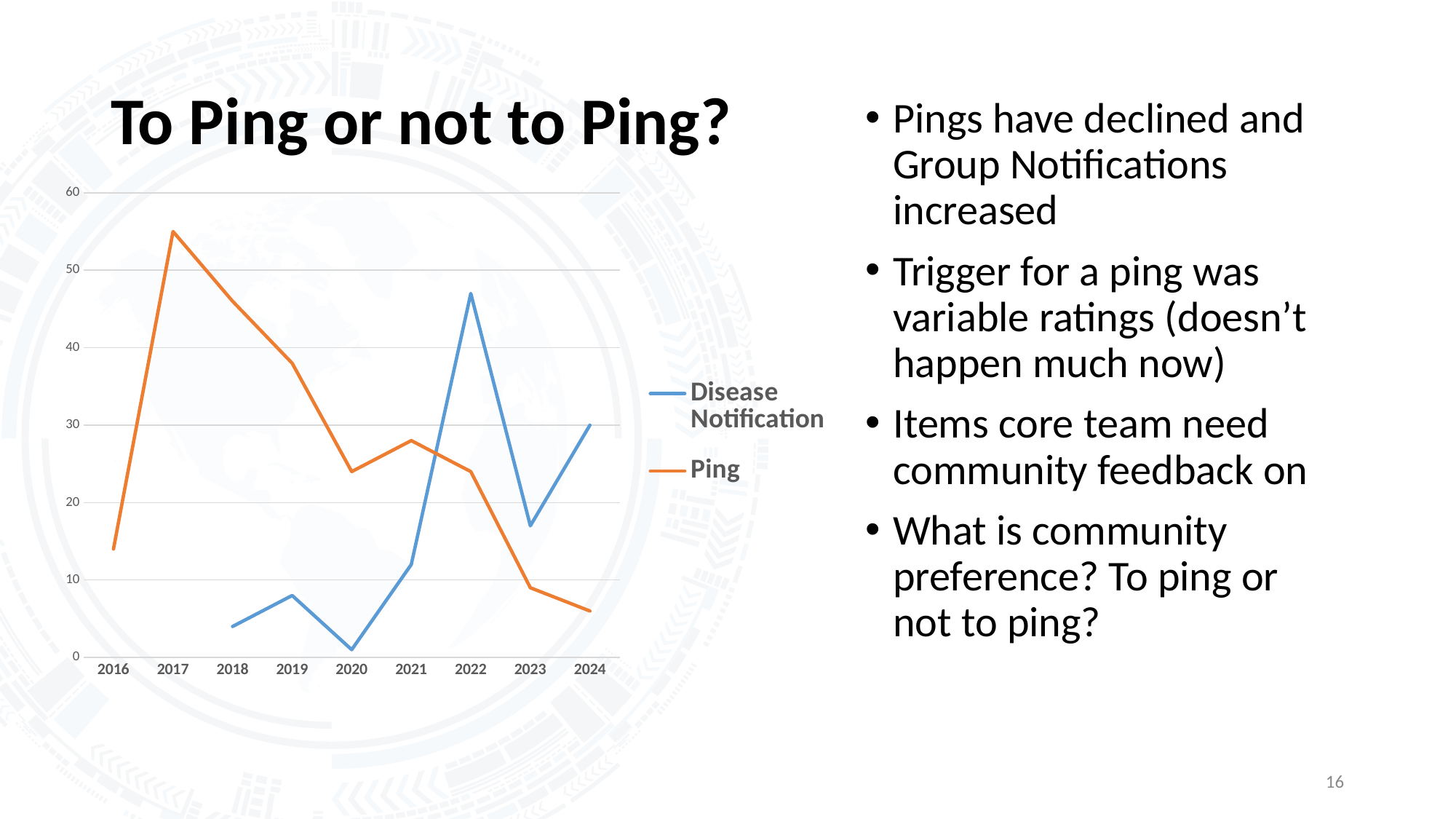
What kind of chart is shown on the slide? line chart Is the Ping value for 2024 greater or less than 10? less How many years are shown on the x axis of the chart? 9 In which year does the Disease Notification series reach its highest value? 2022 Is the Disease Notification value for 2022 greater or less than 40? greater In which year does the Disease Notification series reach its lowest value? 2020 In which year does the Ping series reach its highest value? 2017 Is the Ping value for 2017 greater or less than 50? greater In which year does the Ping series reach its lowest value? 2024 How many series does the chart's legend list? 2 In 2022, which series has the larger value, Disease Notification or Ping? Disease Notification Does the Ping series rise or fall from 2017 to 2020? fall